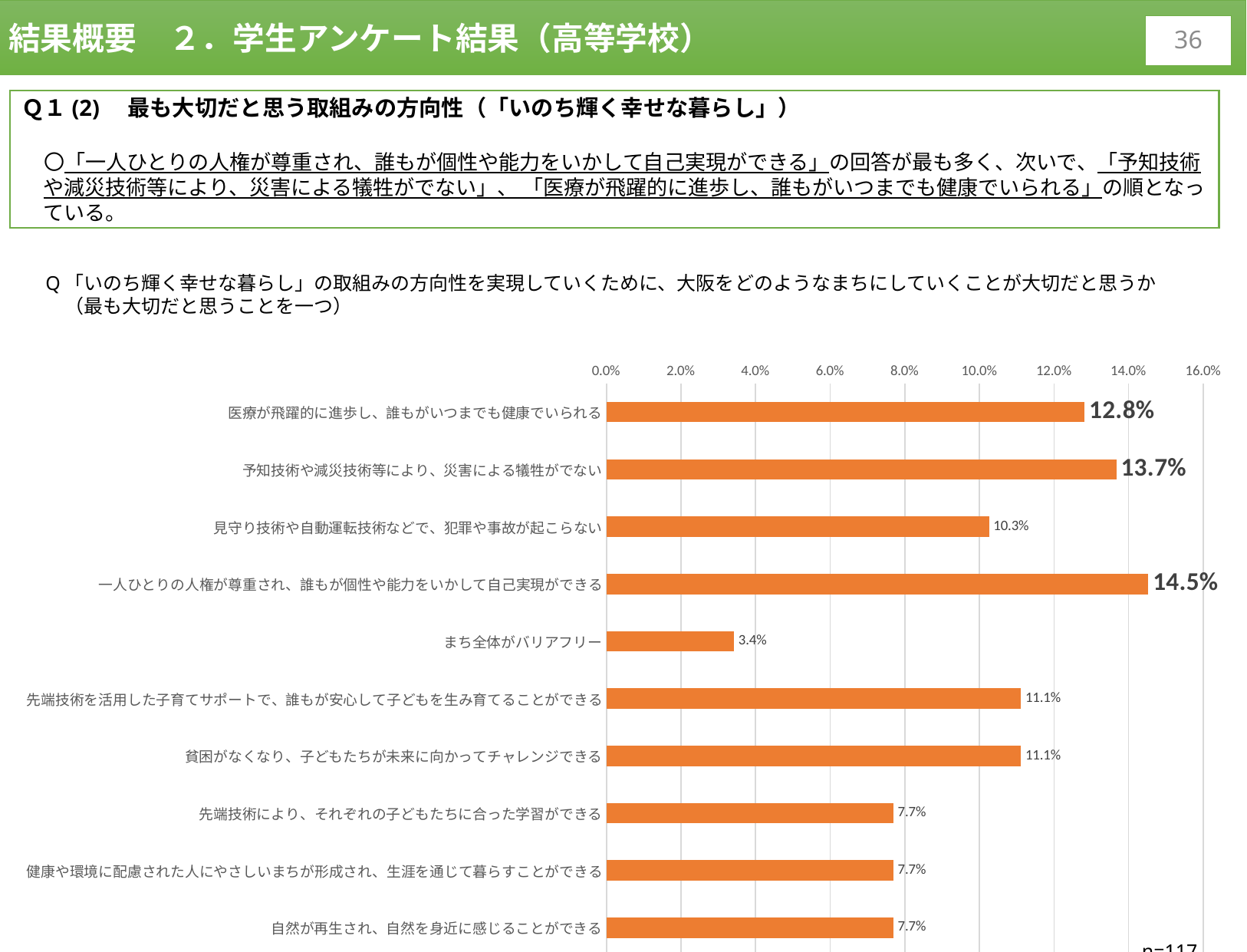
What is the difference between the values for 「一人ひとりの人権が尊重され、誰もが個性や能力をいかして自己実現ができる」 and 「予知技術や減災技術等により、災害による犠牲がでない」? 0.8% What is the value for 「医療が飛躍的に進歩し、誰もがいつまでも健康でいられる」? 12.8% What is the value for 「貧困がなくなり、子どもたちが未来に向かってチャレンジできる」? 11.1% Which is larger: the value for 「医療が飛躍的に進歩し、誰もがいつまでも健康でいられる」 or the value for 「見守り技術や自動運転技術などで、犯罪や事故が起こらない」? 医療が飛躍的に進歩し、誰もがいつまでも健康でいられる Is the value for 「先端技術により、それぞれの子どもたちに合った学習ができる」 greater or less than 8.0%? less Is the value for 「予知技術や減災技術等により、災害による犠牲がでない」 greater or less than 12.0%? greater Which category has the highest value? 一人ひとりの人権が尊重され、誰もが個性や能力をいかして自己実現ができる Which category has the lowest value? まち全体がバリアフリー What is the value for 「見守り技術や自動運転技術などで、犯罪や事故が起こらない」? 10.3% What colour are the bars in the chart? orange What is the value for 「まち全体がバリアフリー」? 3.4% What kind of chart is shown on the slide? bar chart